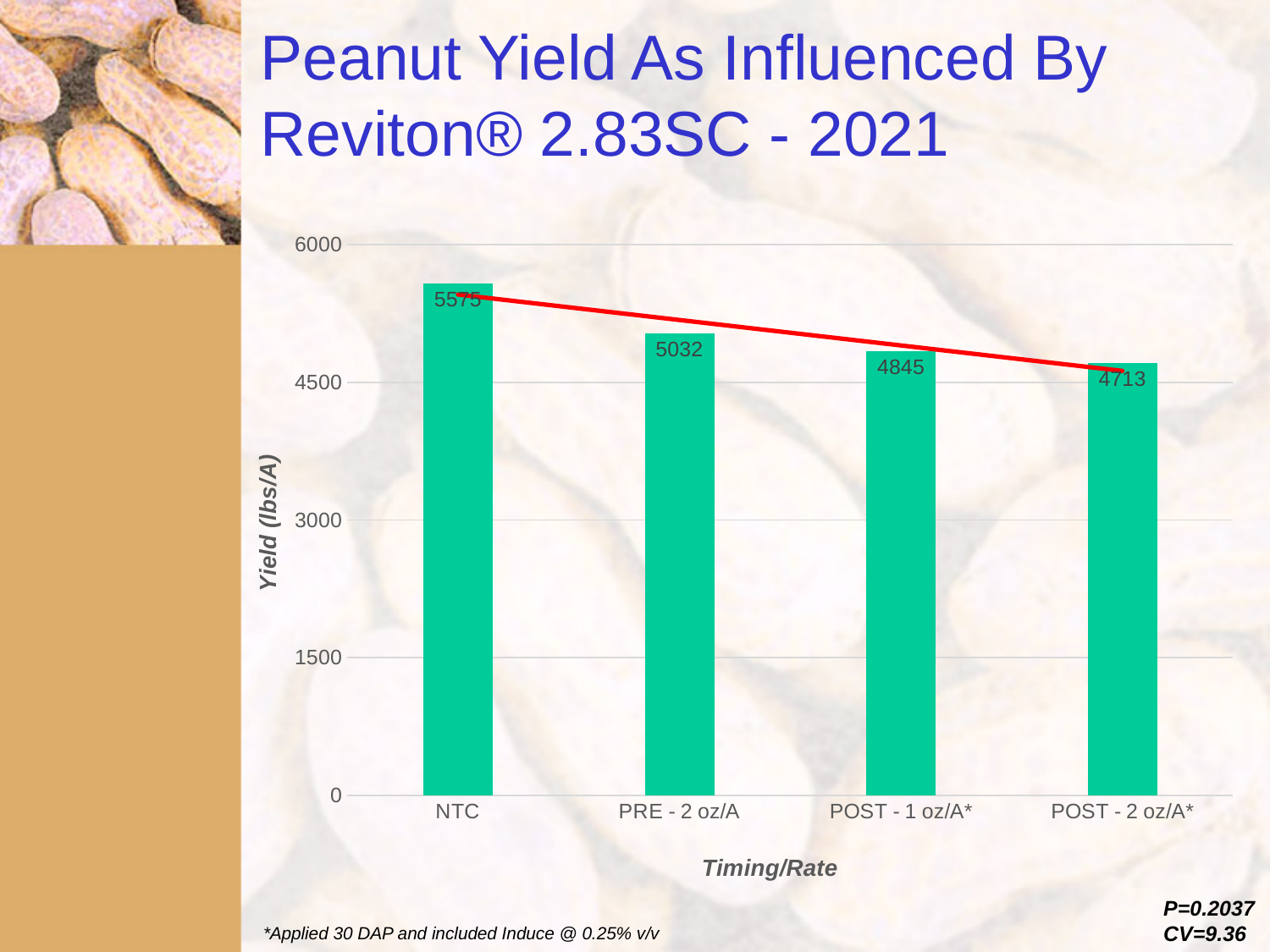
Do the yield values rise or fall from left to right across the treatments? Fall What kind of chart is shown on the slide? Bar chart Which treatment has the lowest yield? POST - 2 oz/A* What is the difference in yield between NTC and POST - 2 oz/A*? 862 Which treatment has the highest yield? NTC How many treatments are shown on the chart? 4 What is the difference in yield between PRE - 2 oz/A and POST - 1 oz/A*? 187 Which has a higher yield, PRE - 2 oz/A or POST - 1 oz/A*? PRE - 2 oz/A What is the yield for NTC? 5575 What is the yield for POST - 1 oz/A*? 4845 What is the yield for POST - 2 oz/A*? 4713 What is the yield for PRE - 2 oz/A? 5032